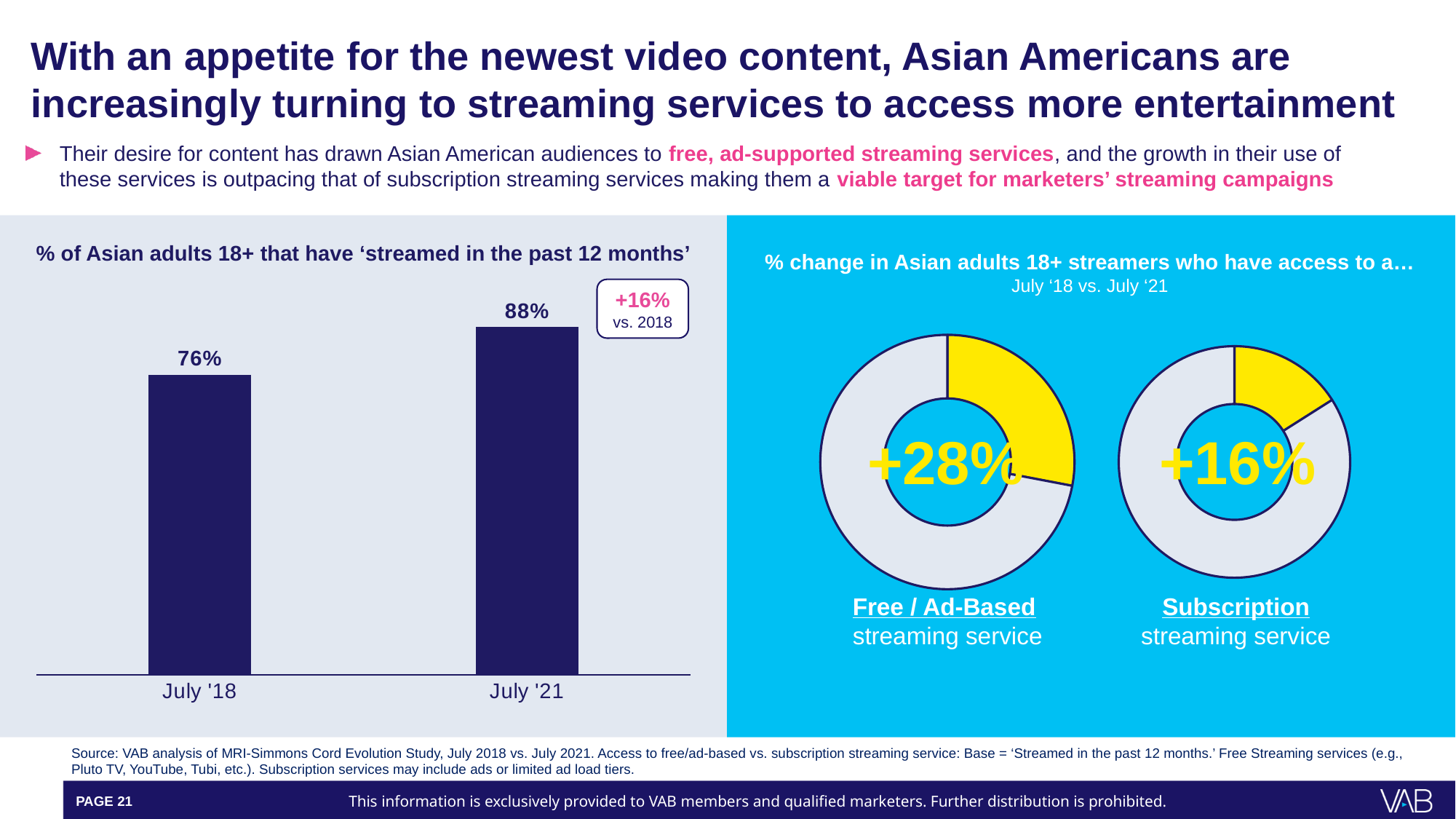
What type of chart is shown on the left side of the slide? Bar chart In the bar chart on the left, which period has the higher value? July '21 In the bar chart on the left, which period has the lower value? July '18 In the bar chart on the left, how many bars are plotted? 2 In the bar chart '% of Asian adults 18+ that have streamed in the past 12 months', what is the value for July '21? 88% In the donut charts on the right, what is the % change for Subscription streaming service? +16% What percentage change vs. 2018 is shown in the callout box next to the July '21 bar? +16% In the bar chart '% of Asian adults 18+ that have streamed in the past 12 months', what is the value for July '18? 76% In the donut charts on the right, what is the % change for Free / Ad-Based streaming service? +28% In the donut charts on the right, which streaming service type shows the larger % change? Free / Ad-Based streaming service In the bar chart on the left, what is the difference in percentage points between July '21 and July '18? 12 In the bar chart on the left, do the values rise or fall from July '18 to July '21? Rise